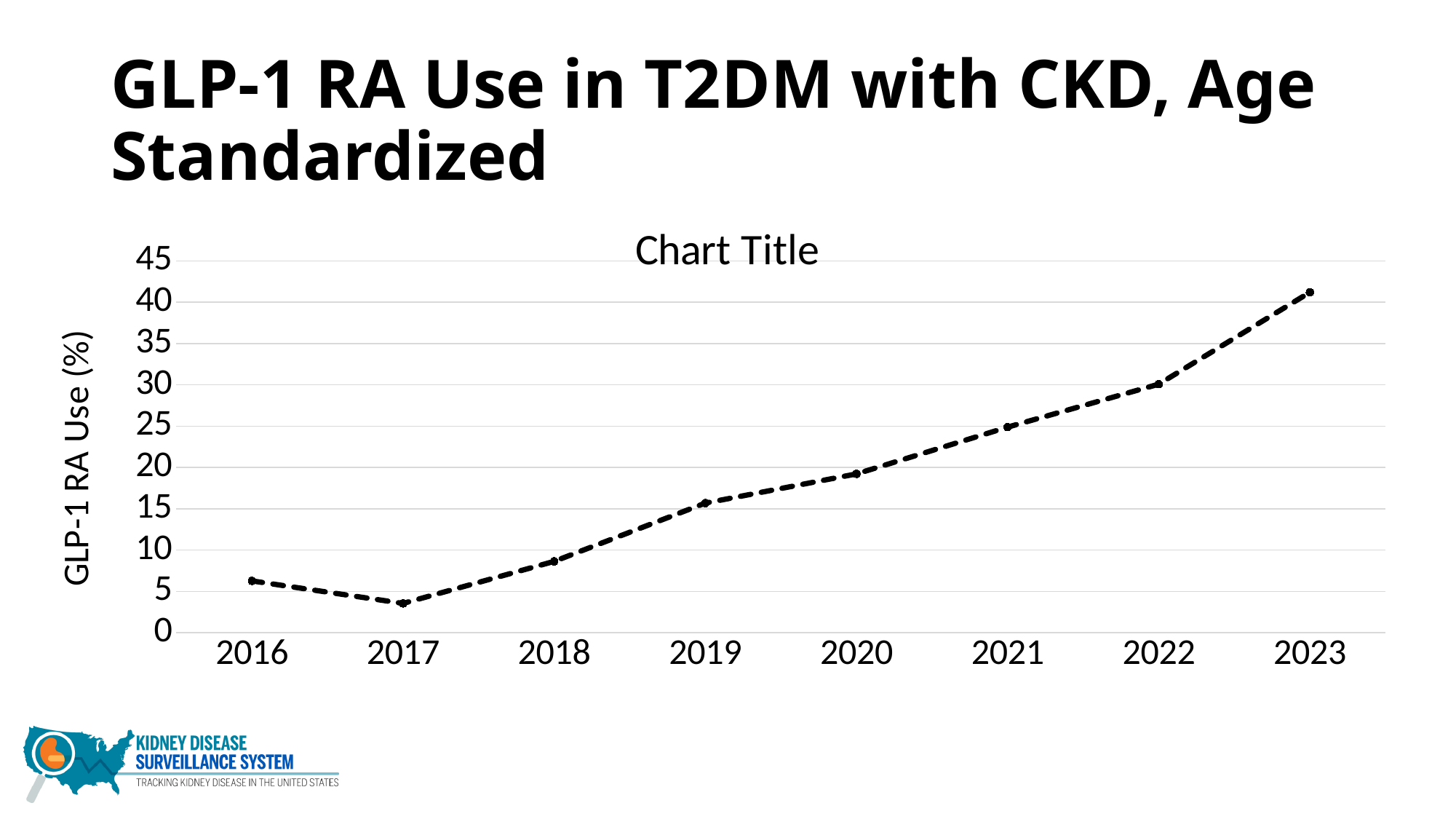
Is the value for 2020 greater or less than 15? greater Do the values generally rise or fall from 2017 to 2023? rise What kind of chart is shown on the slide? line chart How many years are plotted on the x axis? 8 Is the value for 2018 greater or less than 10? less What is the label on the y axis? GLP-1 RA Use (%) Is the value for 2016 greater or less than 5? greater Which year has a higher value, 2019 or 2022? 2022 Which year has the lowest GLP-1 RA use? 2017 Which year has the highest GLP-1 RA use? 2023